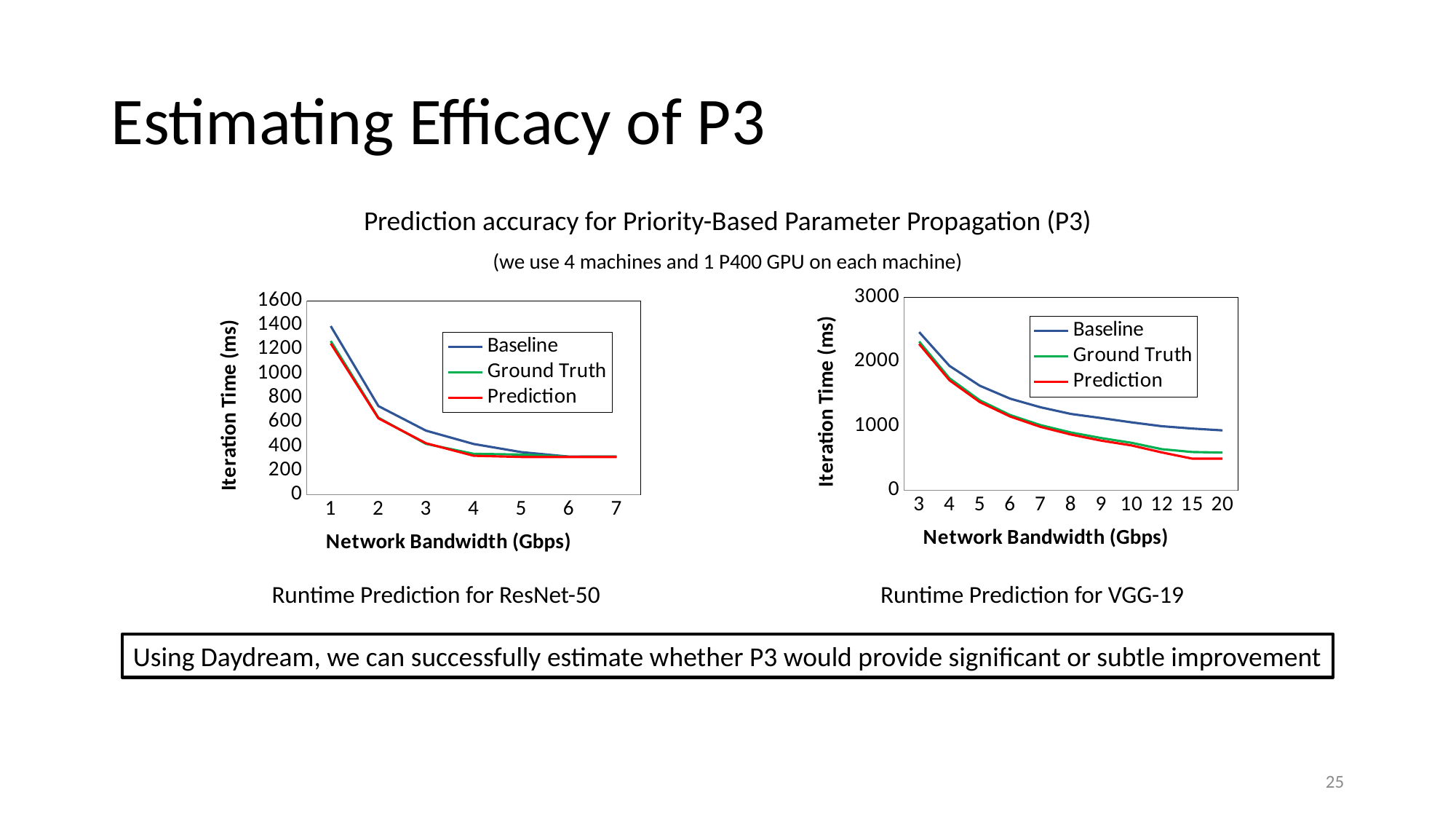
In the Runtime Prediction for VGG-19 chart, is the Prediction value at 20 Gbps greater or less than 1000? less In the Runtime Prediction for VGG-19 chart, does the Prediction iteration time rise or fall as network bandwidth increases? fall What kind of chart is the Runtime Prediction for ResNet-50 chart? line chart How many network bandwidth values are plotted along the x axis of the Runtime Prediction for ResNet-50 chart? 7 How many series does the legend list in the Runtime Prediction for VGG-19 chart? 3 In the Runtime Prediction for ResNet-50 chart, which series has the larger value at 2 Gbps, Baseline or Prediction? Baseline In the Runtime Prediction for ResNet-50 chart, is the Baseline value at 7 Gbps greater or less than 400? less What is the y-axis title of the Runtime Prediction for VGG-19 chart? Iteration Time (ms) In the Runtime Prediction for ResNet-50 chart, is the Baseline value at 1 Gbps greater or less than 1200? greater In the Runtime Prediction for ResNet-50 chart, does the Baseline iteration time rise or fall as network bandwidth increases? fall How many network bandwidth values are plotted along the x axis of the Runtime Prediction for VGG-19 chart? 11